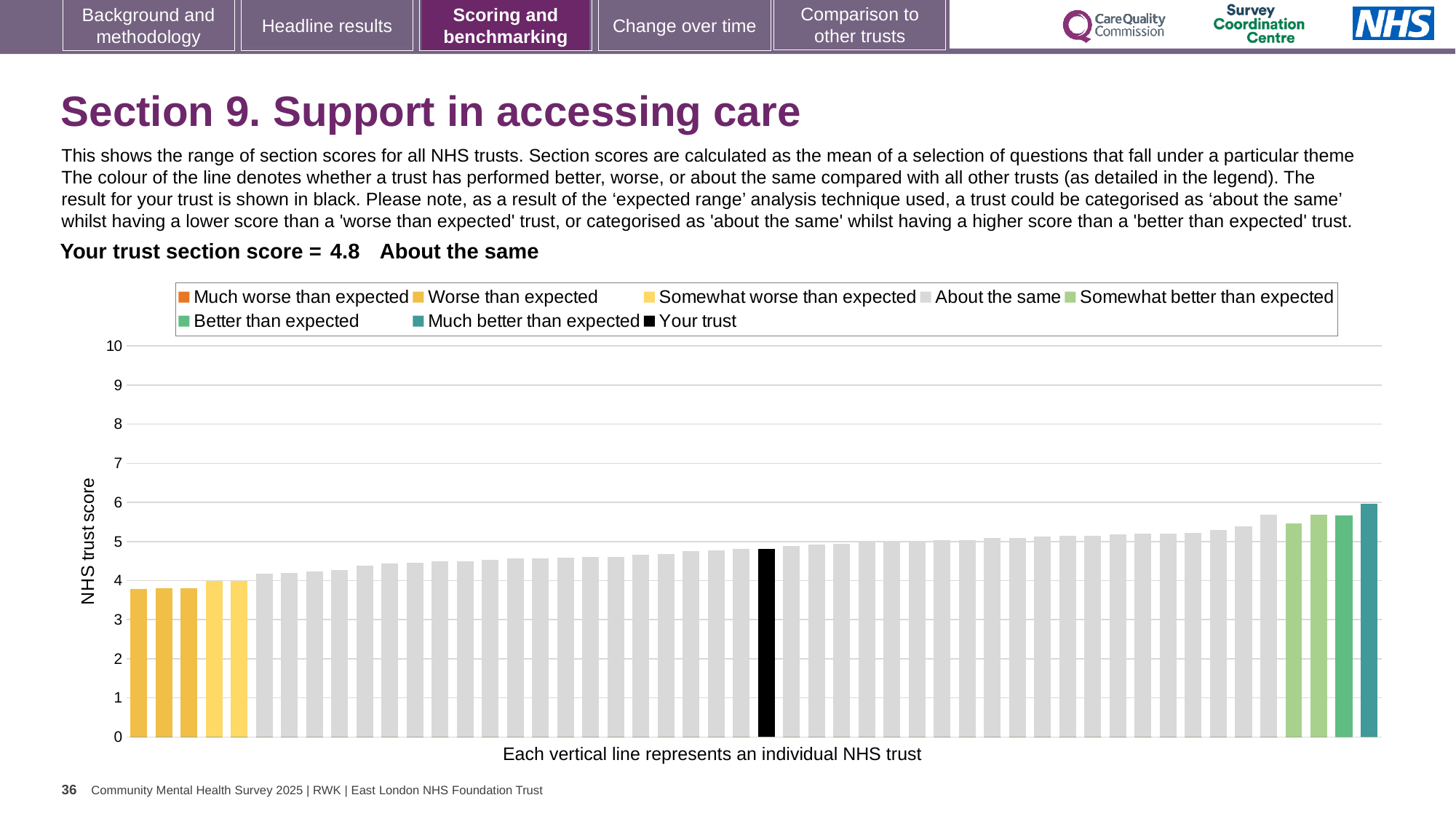
Which is taller: the black bar for your trust or the leftmost bar? the black bar for your trust How many bars are coloured as 'Much better than expected' (teal)? 1 What colour is the bar representing your trust? black How many entries does the chart legend list? 8 Do the bar values rise or fall from left to right across the chart? rise Which category is your trust placed in for this section? About the same What is the section score for your trust shown on the slide? 4.8 Is the value of the bar for your trust greater or less than 5? less What kind of chart is shown on the slide? bar chart Is the value of the leftmost bar in the chart greater or less than 4? less How many bars are coloured as 'Worse than expected' (dark yellow)? 3 Is the value of the tallest bar in the chart greater or less than 5? greater